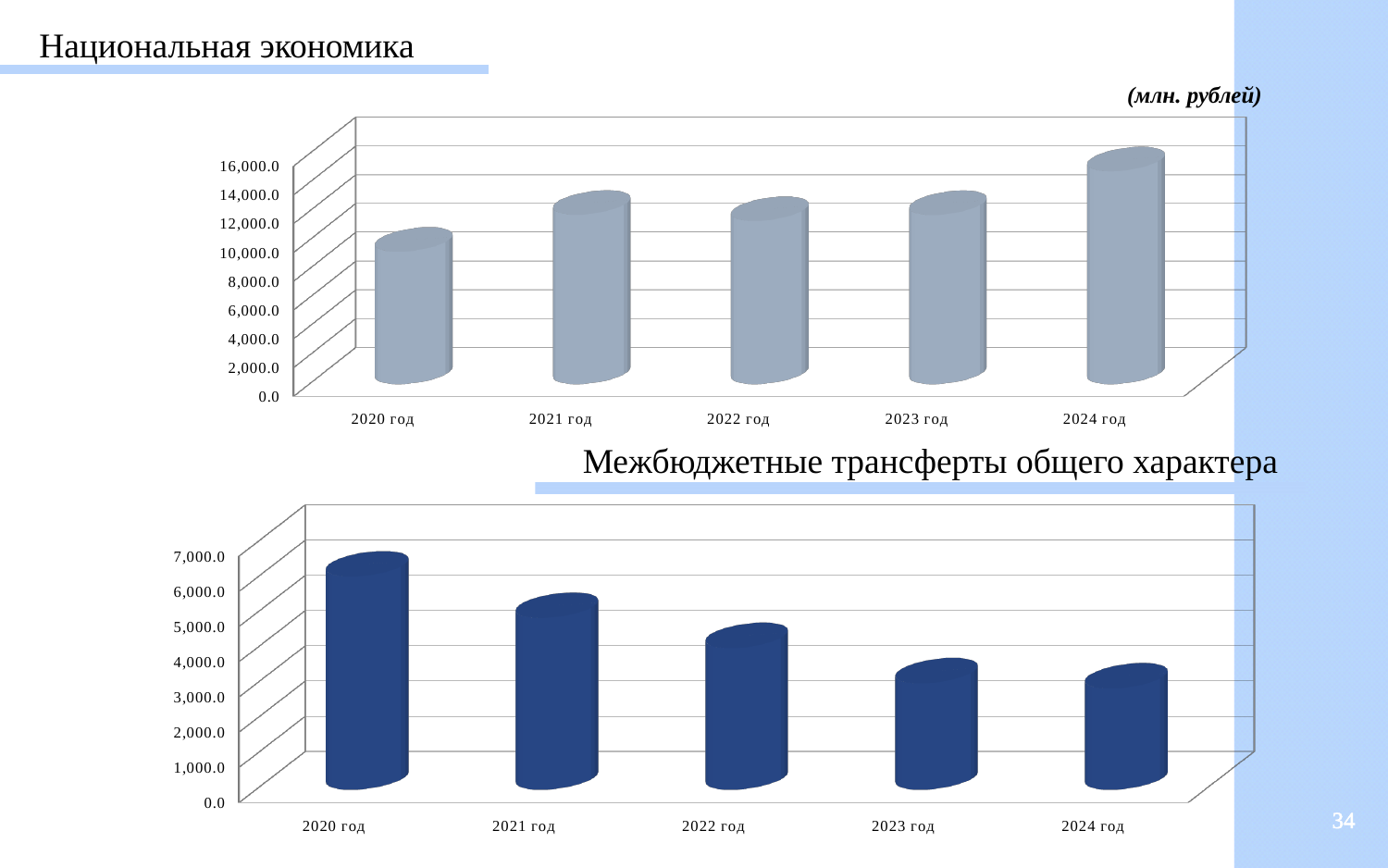
On the bottom chart (Межбюджетные трансферты общего характера), is the value for 2024 год greater or less than 4,000.0? less On the top chart (Национальная экономика), which year has the lowest value? 2020 год What kind of chart is the bottom chart (Межбюджетные трансферты общего характера)? bar chart On the bottom chart (Межбюджетные трансферты общего характера), which year has the highest value? 2020 год What unit is stated for the values on the slide? млн. рублей On the top chart (Национальная экономика), which year has the highest value? 2024 год On the bottom chart (Межбюджетные трансферты общего характера), do the values rise or fall from 2020 год to 2024 год? fall On the top chart (Национальная экономика), which is larger: the value for 2020 год or 2024 год? 2024 год On the bottom chart (Межбюджетные трансферты общего характера), is the value for 2020 год greater or less than 5,000.0? greater On the top chart (Национальная экономика), is the value for 2024 год greater or less than 14,000.0? greater How many years are shown on the top chart (Национальная экономика)? 5